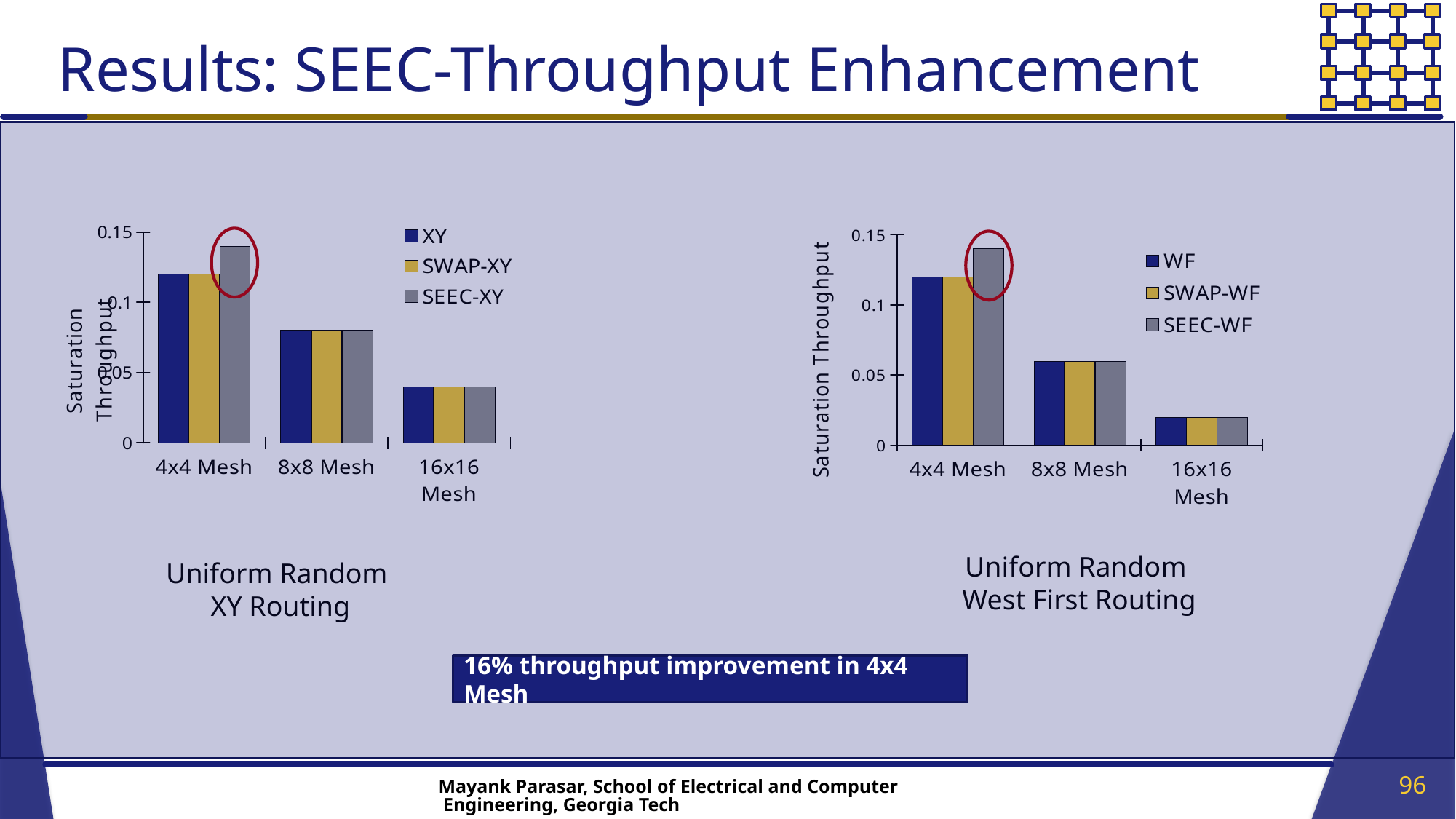
In the right chart (Uniform Random West First Routing), is the SEEC-WF value for 8x8 Mesh greater or less than 0.1? less In the right chart (Uniform Random West First Routing), is the WF value for 4x4 Mesh greater or less than 0.1? greater In the left chart (Uniform Random XY Routing), which series has the highest value for 4x4 Mesh? SEEC-XY In the left chart (Uniform Random XY Routing), is the XY value for 16x16 Mesh greater or less than 0.05? less In the right chart (Uniform Random West First Routing), how many mesh categories are shown on the x axis? 3 In the left chart (Uniform Random XY Routing), what kind of chart is shown? bar chart In the left chart (Uniform Random XY Routing), how many series does the legend list? 3 In the left chart (Uniform Random XY Routing), which is larger for 4x4 Mesh: the SEEC-XY value or the SWAP-XY value? SEEC-XY In the right chart (Uniform Random West First Routing), what is the label of the y axis? Saturation Throughput In the right chart (Uniform Random West First Routing), which mesh size has the lowest saturation throughput? 16x16 Mesh In the right chart (Uniform Random West First Routing), do the saturation throughput values rise or fall as the mesh size increases along the x axis? fall